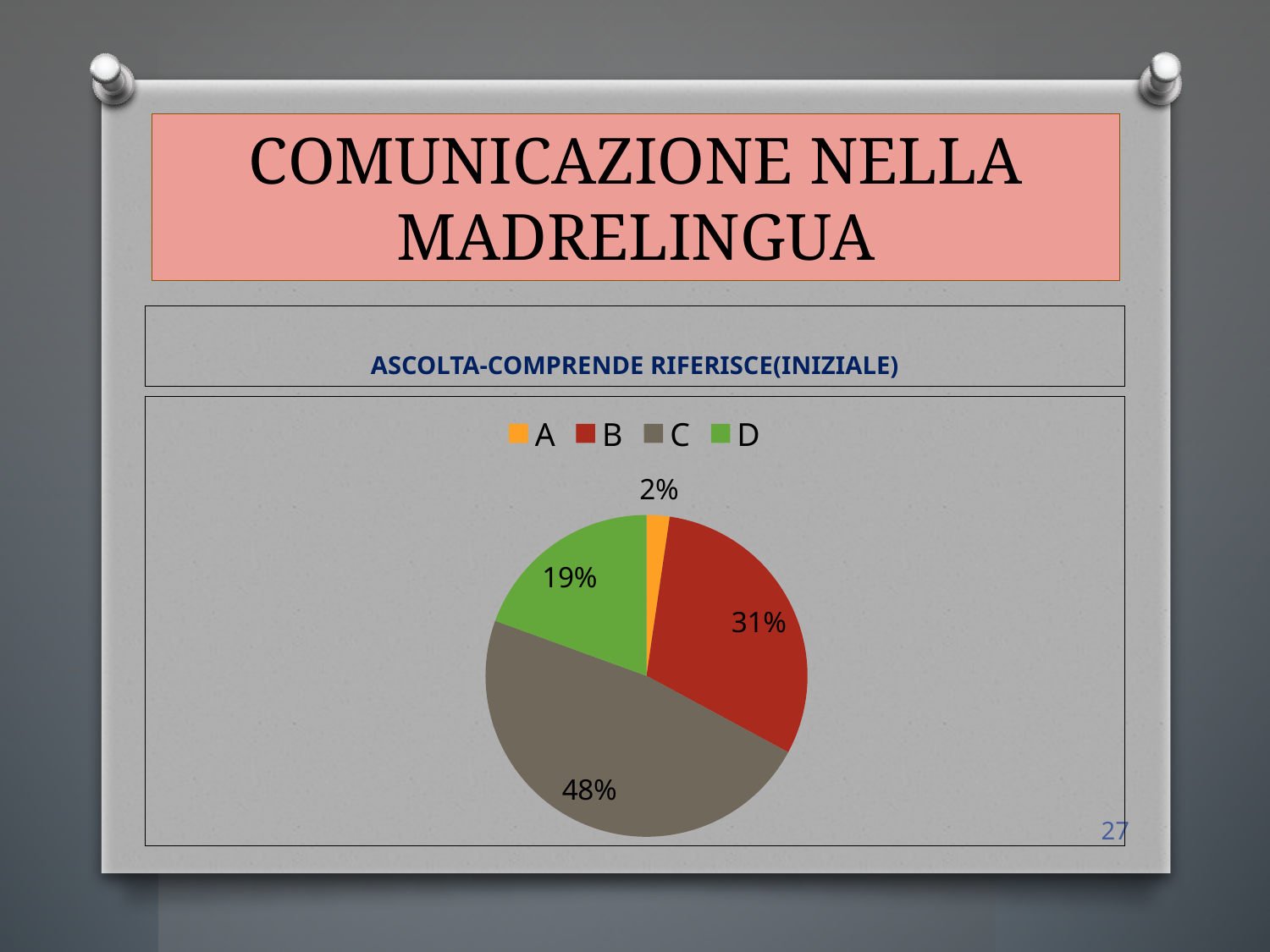
What share of the pie does category A have? 2% What colour is the slice for category D? green Which category has the largest slice of the pie? C What is the title of the chart? ASCOLTA-COMPRENDE RIFERISCE(INIZIALE) What is the difference in percentage points between the slices for C and B? 17 What kind of chart is shown on the slide? pie chart What share of the pie does category D have? 19% What share of the pie does category B have? 31% Which is larger, the slice for B or the slice for D? B Which category has the smallest slice of the pie? A How many categories does the legend list? 4